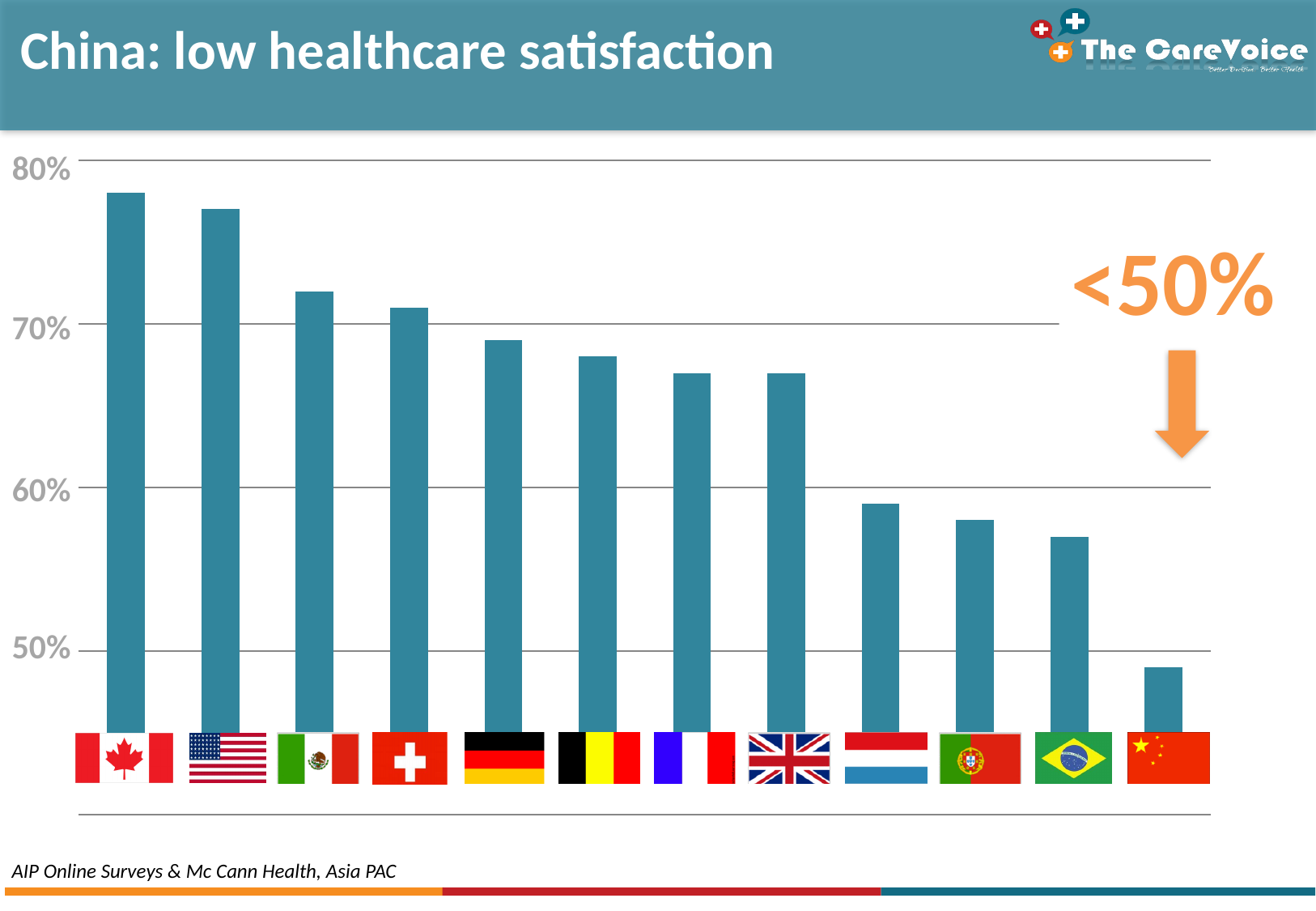
Is the value for China greater or less than 50%? less How many countries (bars) are shown in the chart? 12 Is the value for Brazil greater or less than 60%? less Which country has the lowest healthcare satisfaction in the chart? China What kind of chart is shown on the slide? bar chart Is the value for Germany greater or less than 60%? greater What is the title of the slide containing the chart? China: low healthcare satisfaction Which is larger, the value for Canada or the value for China? Canada Which is larger, the value for Mexico or the value for Brazil? Mexico Do the bar values rise or fall from left to right across the chart? fall